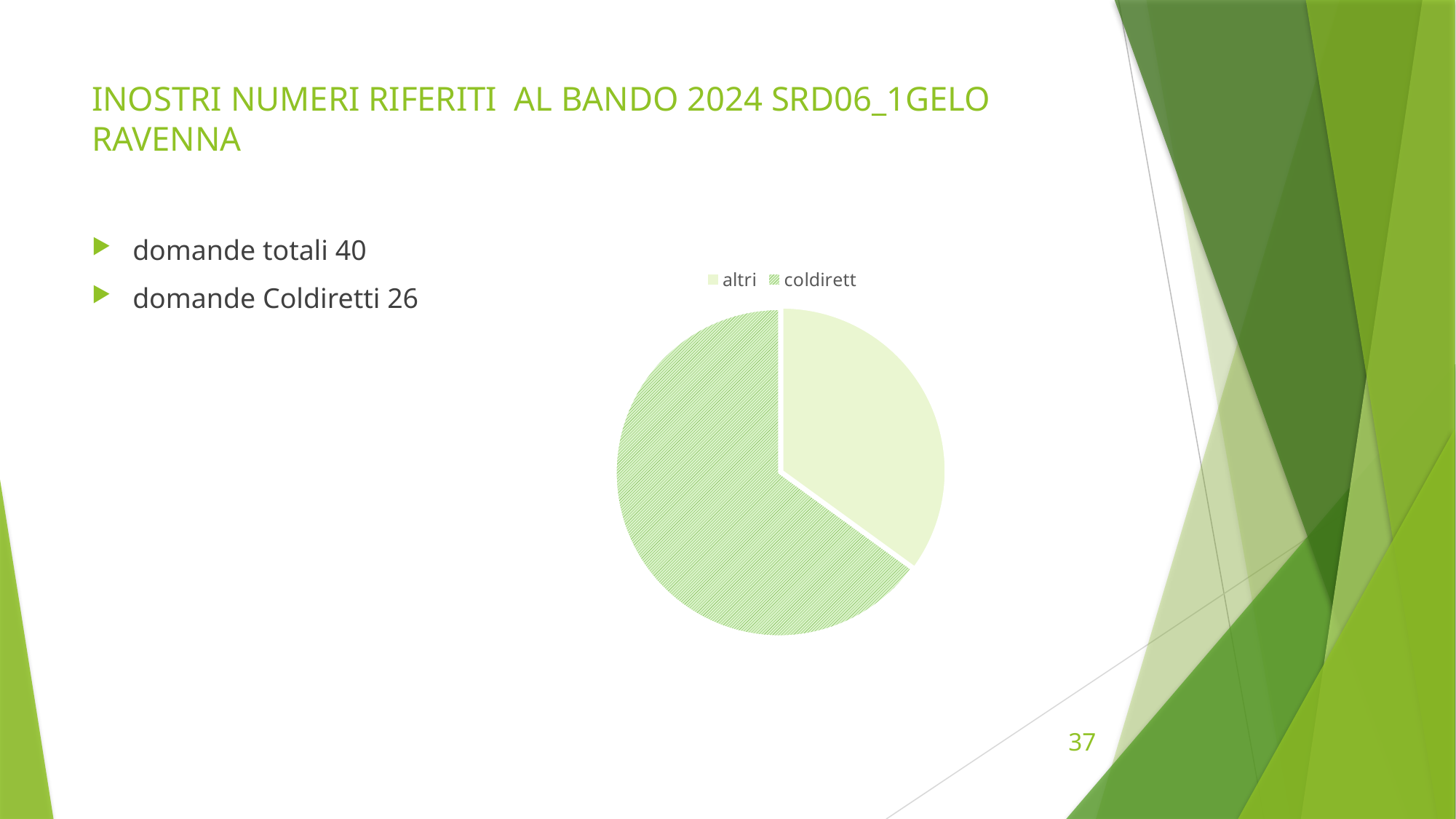
Does the coldirett slice represent more or less than half of the pie? more How many slices does the pie chart have? 2 How many entries does the legend of the pie chart list? 2 What are the two legend entries of the pie chart? altri and coldirett What kind of chart is shown on the slide? pie chart Which slice of the pie chart is the largest? coldirett Which slice of the pie chart is the smallest? altri Which slice is larger in the pie chart, altri or coldirett? coldirett According to the slide, what is the total number of domande? 40 According to the slide, how many domande are attributed to Coldiretti? 26 Which slice of the pie chart is drawn with a hatched (striped) pattern? coldirett